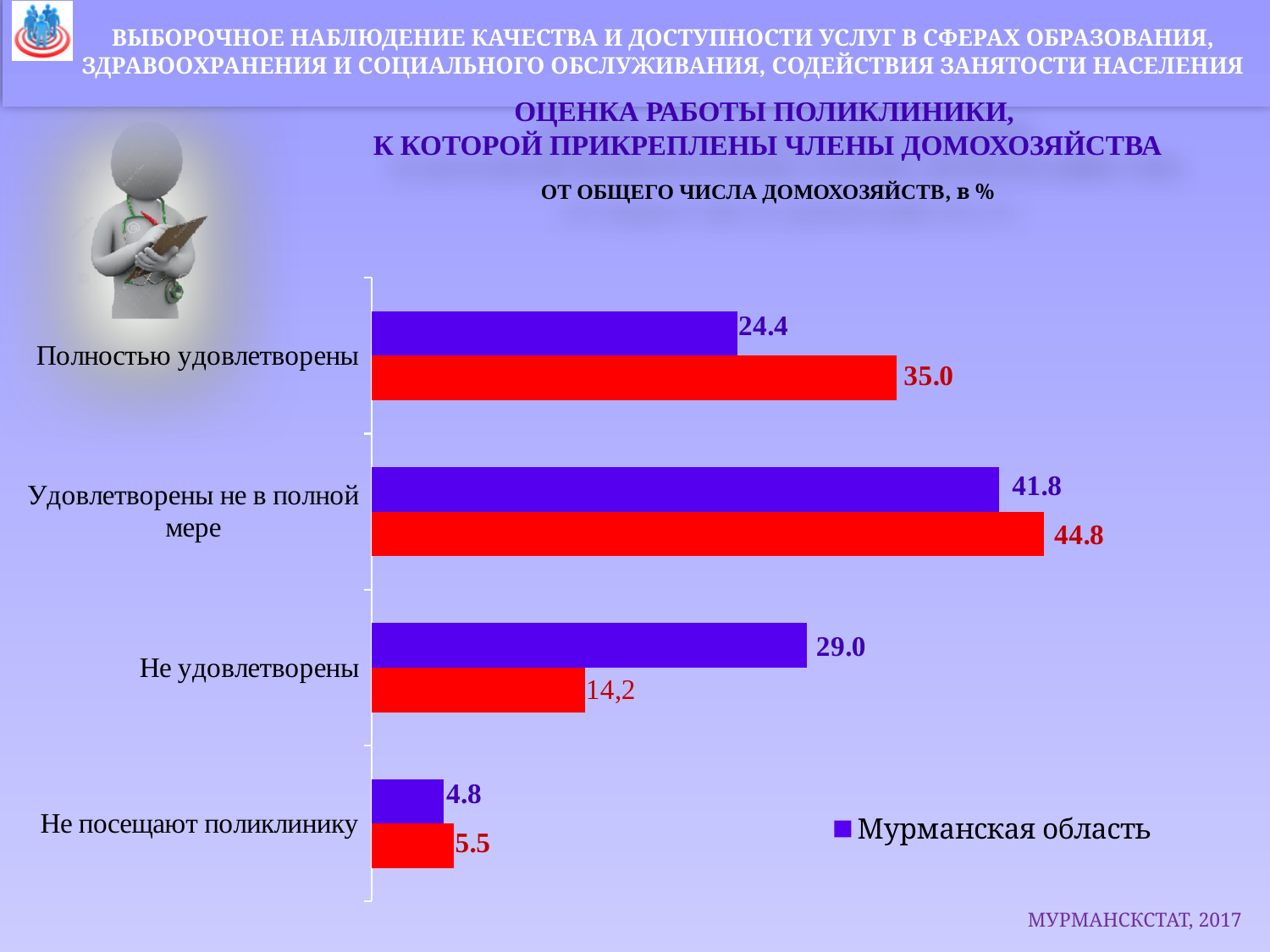
What is the value for Мурманская область in the category 'Полностью удовлетворены'? 24.4 What type of chart is shown on the slide? bar chart What series name is shown in the chart legend? Мурманская область How many series does the legend list? 1 What is the difference between the red bar and the Мурманская область bar in the category 'Полностью удовлетворены'? 10.6 What is the value of the red bar in the category 'Удовлетворены не в полной мере'? 44.8 In the category 'Не удовлетворены', which is larger: the Мурманская область bar or the red bar? Мурманская область What is the value for Мурманская область in the category 'Не удовлетворены'? 29.0 Which category has the lowest value for the red series? Не посещают поликлинику How many categories are shown on the chart? 4 What is the value of the red bar in the category 'Не посещают поликлинику'? 5.5 Which category has the highest value for Мурманская область? Удовлетворены не в полной мере